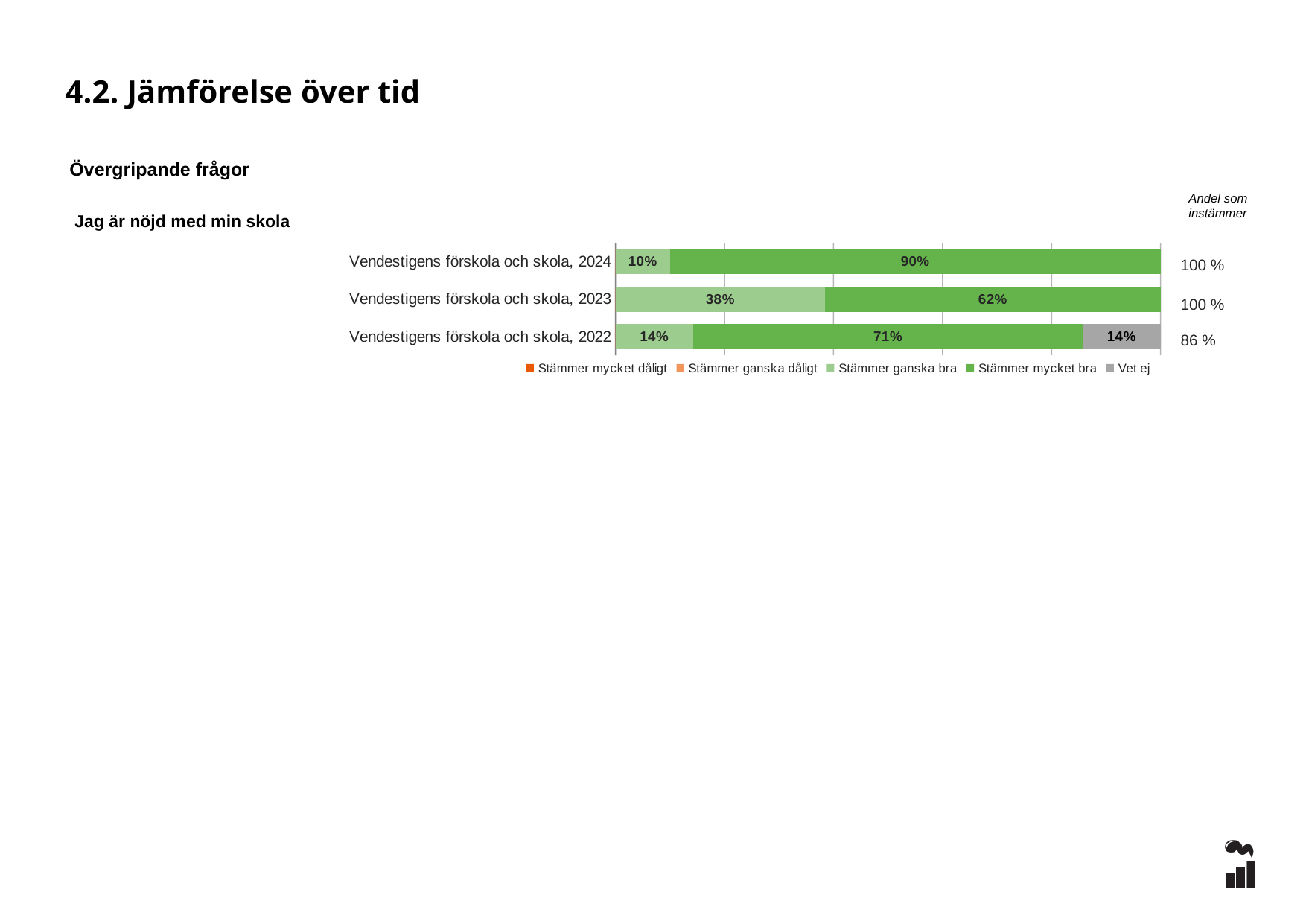
Which is larger: the "Stämmer ganska bra" value for 2023 or for 2022? Vendestigens förskola och skola, 2023 Which year has the lowest value for "Stämmer mycket bra"? Vendestigens förskola och skola, 2023 Which year has the highest value for "Stämmer mycket bra"? Vendestigens förskola och skola, 2024 What is the value for "Stämmer ganska bra" for Vendestigens förskola och skola, 2023? 38% What kind of chart is shown on the slide? Stacked bar chart What is the "Andel som instämmer" value shown for Vendestigens förskola och skola, 2022? 86 % How many categories (bars) does the chart show? 3 What is the value for "Stämmer mycket bra" for Vendestigens förskola och skola, 2024? 90% What is the value for "Vet ej" for Vendestigens förskola och skola, 2022? 14% What is the difference between the "Stämmer mycket bra" values for 2024 and 2023? 28% How many series does the legend list? 5 What is the value for "Stämmer mycket bra" for Vendestigens förskola och skola, 2022? 71%